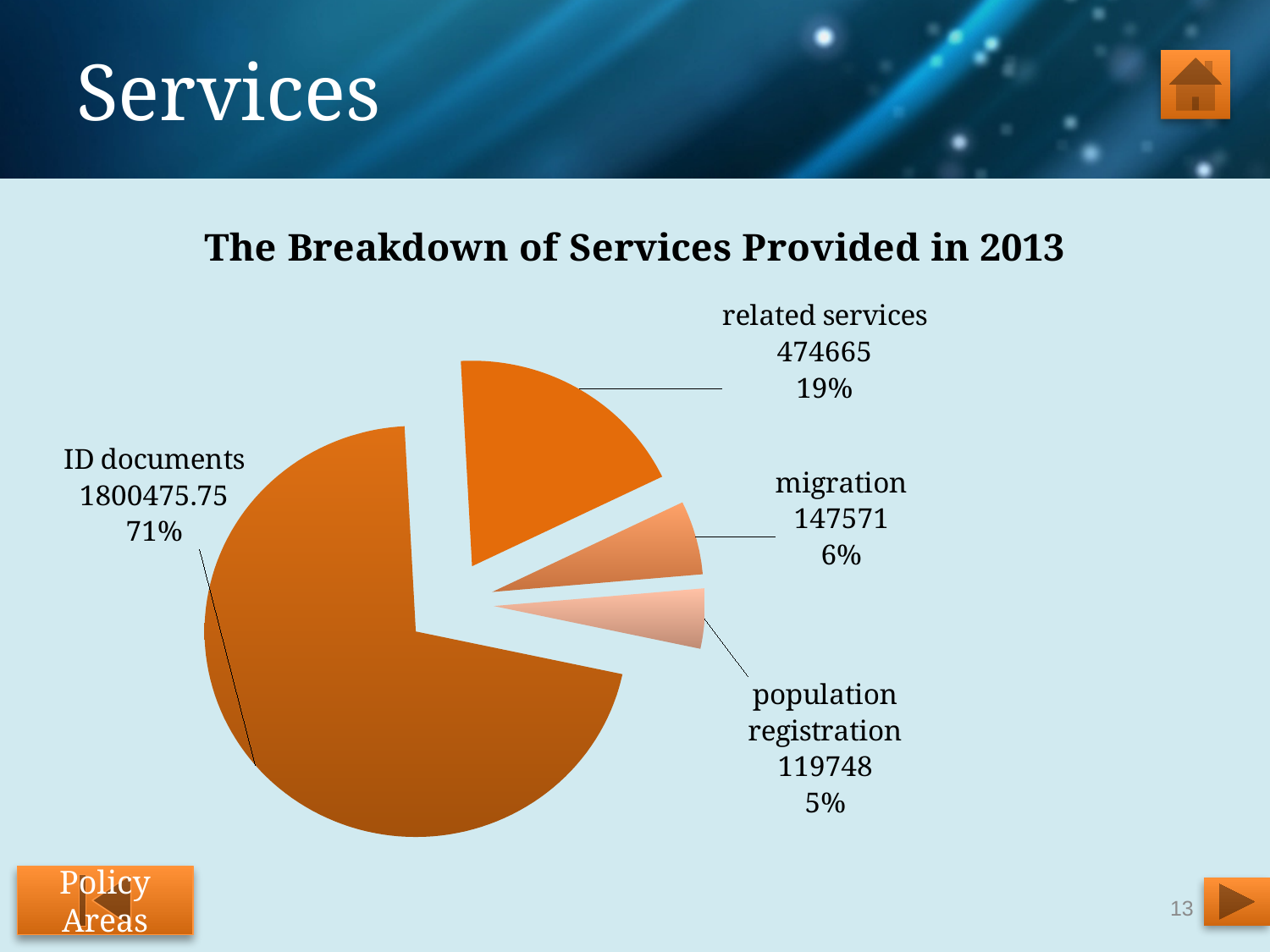
Which category has the smallest slice? population registration What is the value for migration? 147571 What is the value for population registration? 119748 What is the value for related services? 474665 How many categories are shown in the pie chart? 4 What kind of chart is shown on the slide? pie chart What is the title of the chart? The Breakdown of Services Provided in 2013 What is the difference between the values for migration and population registration? 27823 Which category has the largest slice? ID documents What share of the pie does ID documents represent? 71% What share of the pie does related services represent? 19% What is the value for ID documents? 1800475.75